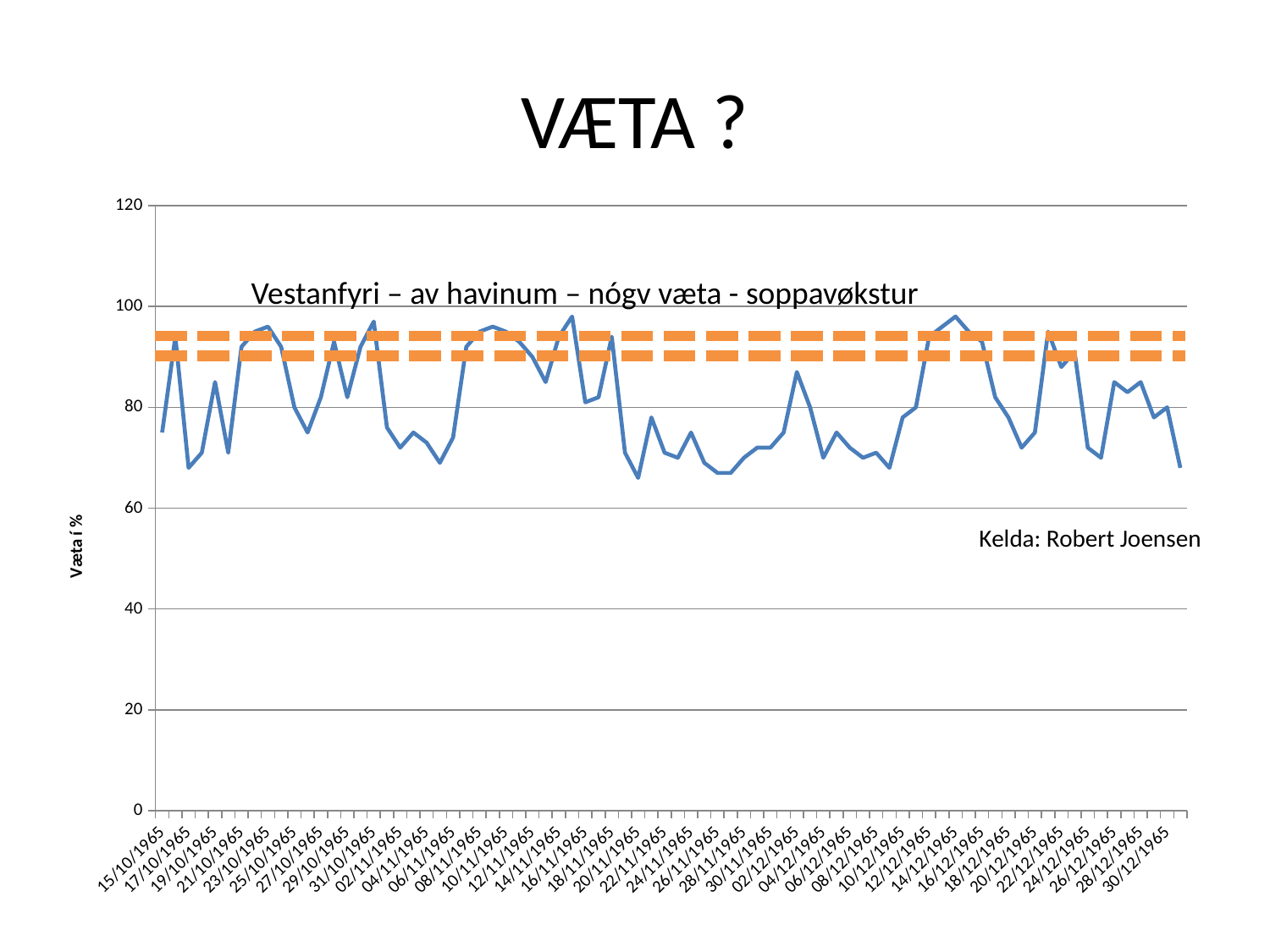
Which has the higher value, 15/10/1965 or 24/10/1965? 24/10/1965 Which has the higher value, 16/11/1965 or 20/11/1965? 16/11/1965 Is the value for 20/11/1965 greater or less than 80? less Is the value for 14/12/1965 greater or less than 80? greater Is the value for 24/10/1965 greater or less than 80? greater What is the label of the vertical axis? Væta í % What kind of chart is shown on the slide? line chart What is the highest value shown on the vertical axis? 120